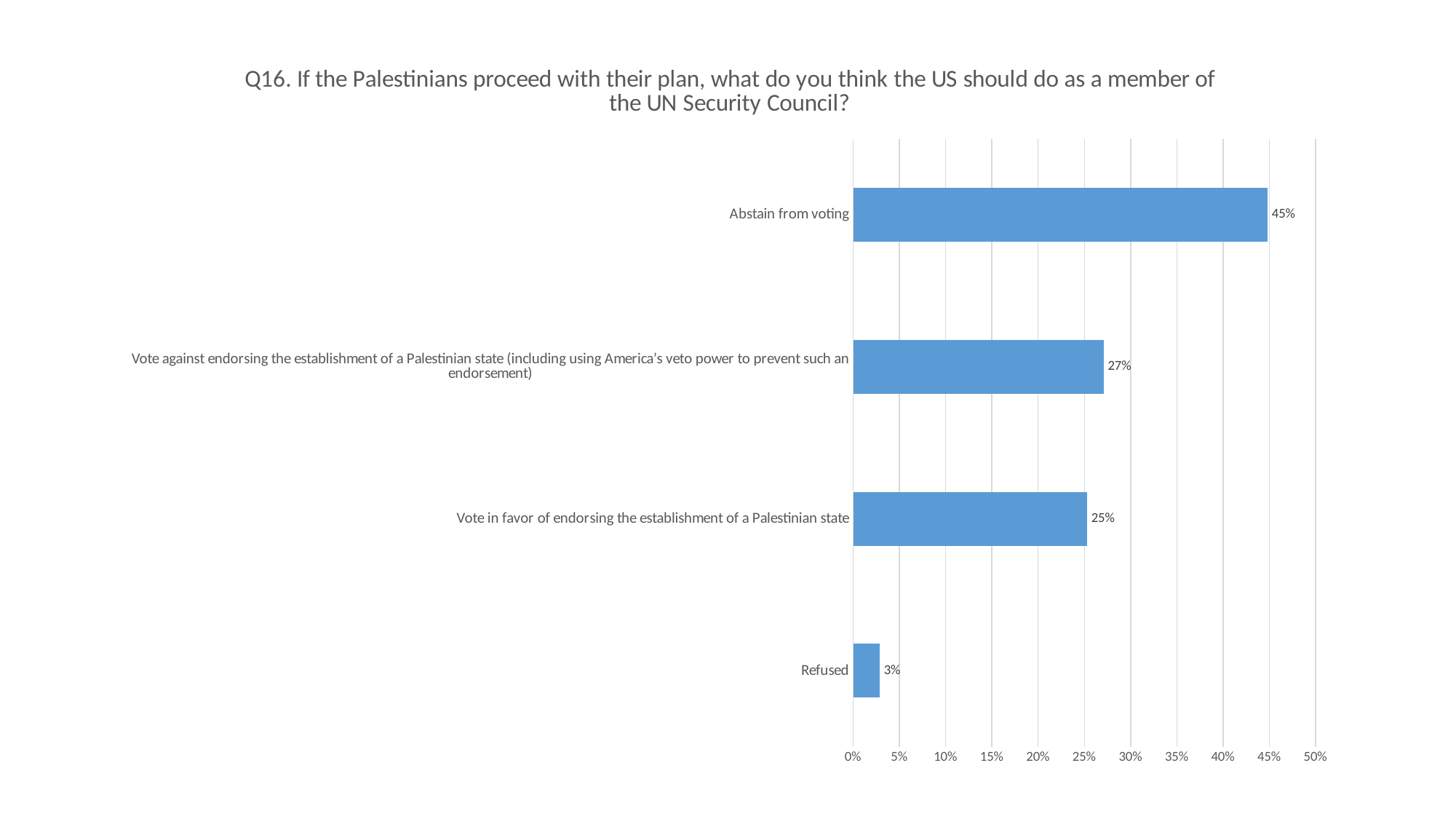
What percentage of respondents said the US should abstain from voting? 45% How many response categories are shown in the chart? 4 What type of chart is shown on the slide? Bar chart What is the maximum value shown on the percentage axis? 50% What is the difference in percentage points between "Abstain from voting" and "Vote in favor of endorsing the establishment of a Palestinian state"? 20 percentage points What is the difference between the "Vote against" option and the "Vote in favor" option? 2 percentage points Which response option has the highest percentage? Abstain from voting What is the value for "Vote in favor of endorsing the establishment of a Palestinian state"? 25% Which response option has the lowest percentage? Refused Which is larger: the value for "Abstain from voting" or the value for "Vote against endorsing the establishment of a Palestinian state"? Abstain from voting What is the value for "Vote against endorsing the establishment of a Palestinian state (including using America's veto power to prevent such an endorsement)"? 27% What percentage of respondents refused to answer? 3%